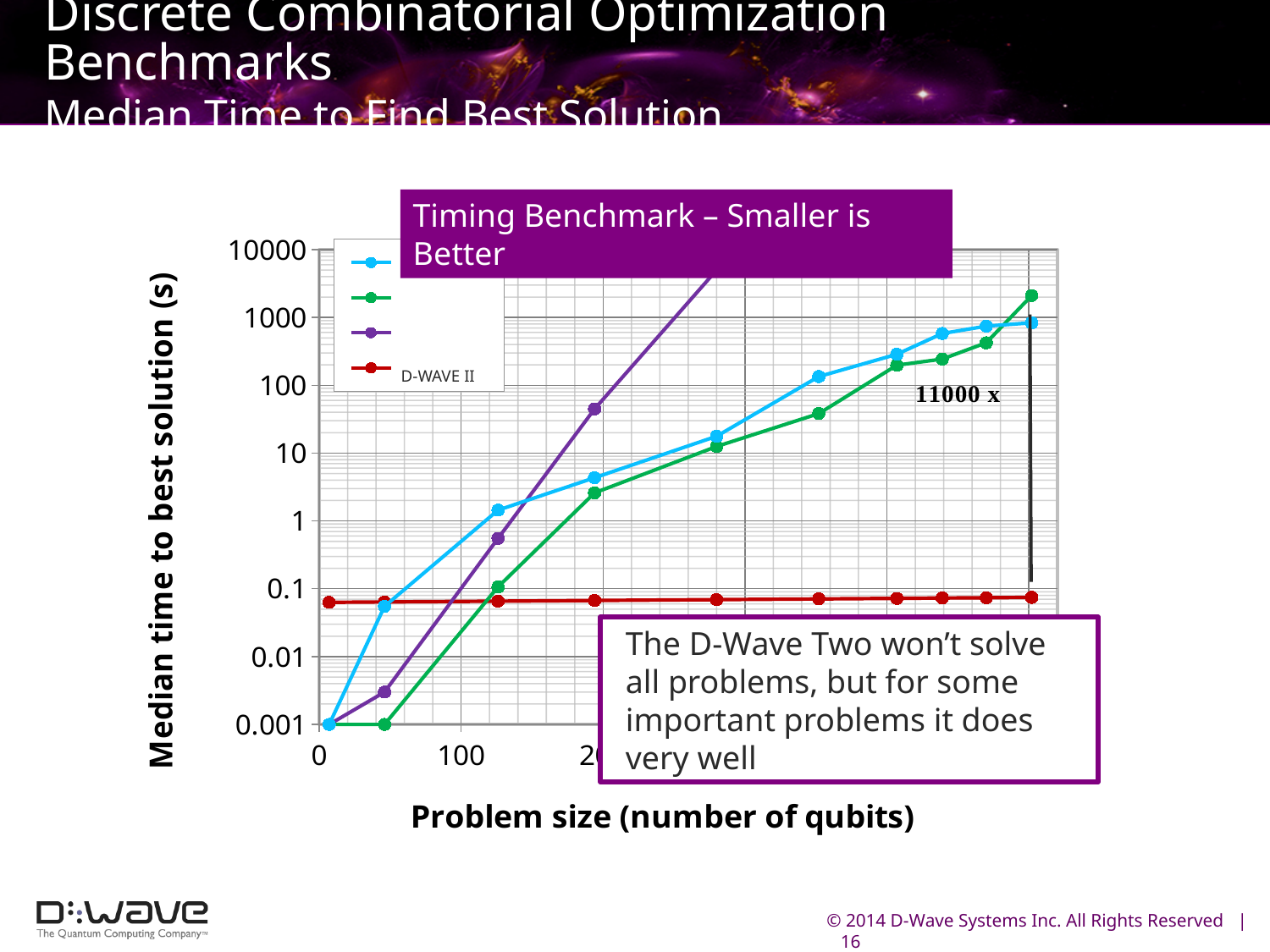
At the largest problem size plotted, which series has the higher median time, the green line or the cyan line? the green line Is the D-WAVE II median time at a problem size of 100 qubits greater or less than 0.01 seconds? greater Is the purple series' value at a problem size of about 250 qubits greater or less than 10 seconds? greater How many series does the chart's legend list? 4 Is the D-WAVE II median time at a problem size of 100 qubits greater or less than 0.1 seconds? less Does the median time for the cyan series rise or fall as problem size increases? rises What is the label of the chart's y axis? Median time to best solution (s) What kind of chart is shown on the slide? line chart Which series in the legend is labelled D-WAVE II? the red line Does the purple series rise or fall as problem size increases? rises